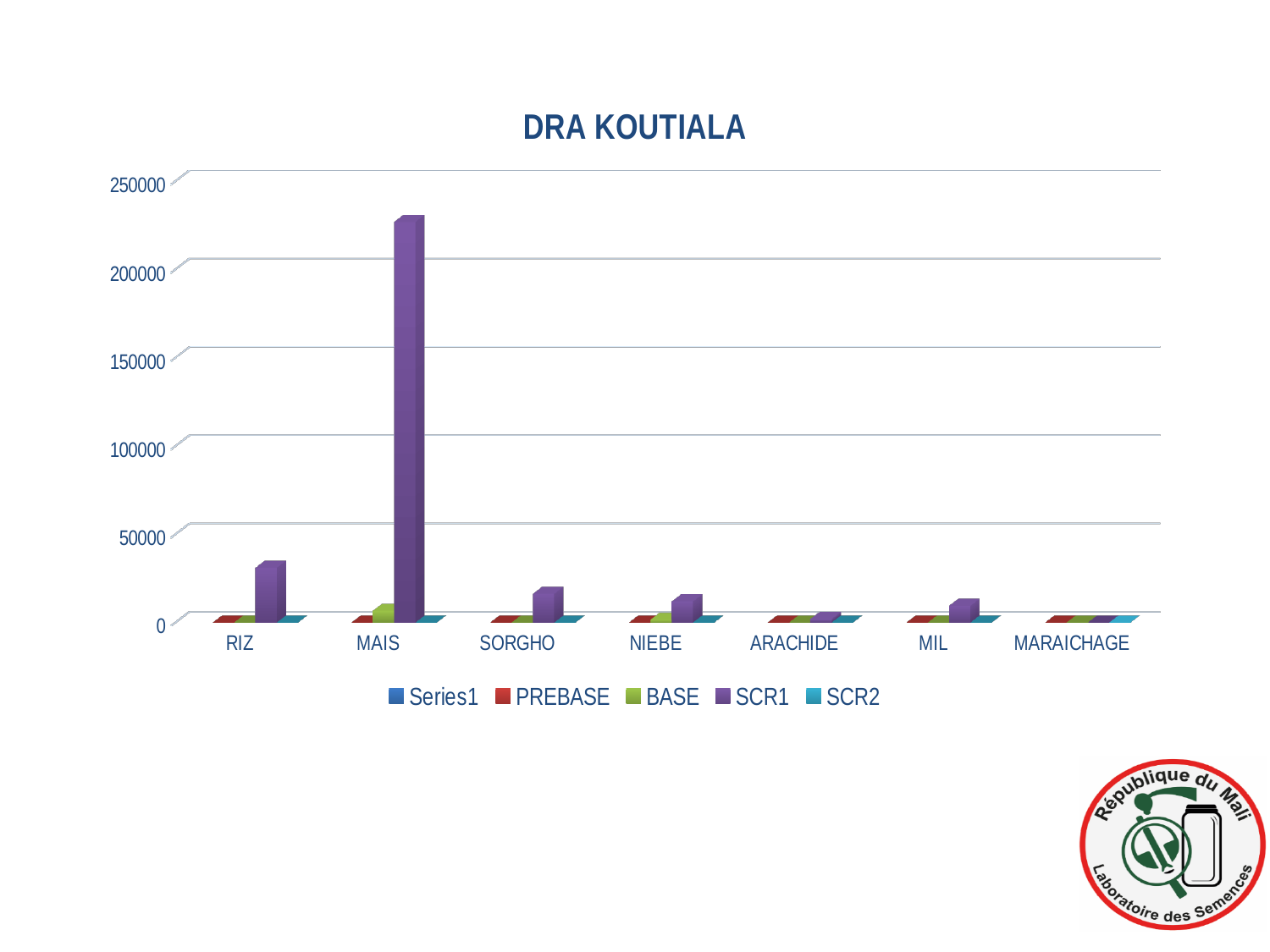
Which category has the highest SCR1 value? MAIS Is the SCR1 value for MAIS greater or less than 250000? less Which is larger, the SCR1 value for RIZ or the SCR1 value for SORGHO? RIZ Is the SCR1 value for SORGHO greater or less than 50000? less How many categories are shown on the x axis of the chart? 7 How many series does the legend list? 5 Which series is shown in purple in the legend? SCR1 What kind of chart is shown on the slide? bar chart What is the title of the chart? DRA KOUTIALA Which is larger, the SCR1 value for MAIS or the SCR1 value for RIZ? MAIS Is the SCR1 value for MAIS greater or less than 200000? greater